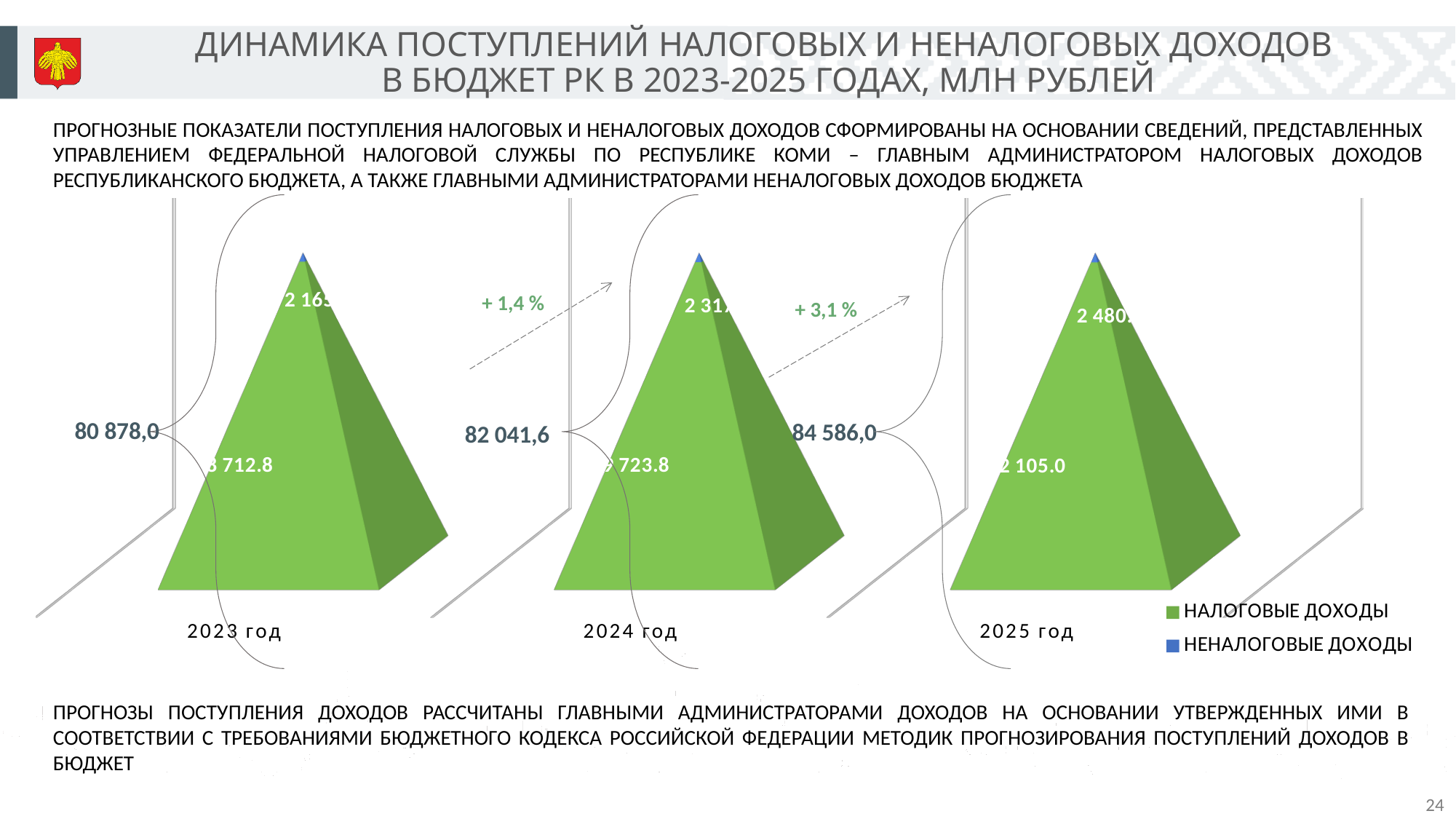
Which year has the lowest total revenue? 2023 год Which year has the highest total revenue? 2025 год What is the total revenue shown for 2025 год? 84 586,0 What is the total revenue shown for 2023 год? 80 878,0 Do the total revenues rise or fall from 2023 to 2025? rise How many years are shown on the chart? 3 What is the difference between the total for 2025 год and the total for 2023 год? 3 708,0 What is the total revenue shown for 2024 год? 82 041,6 How many series does the legend list? 2 What is the difference between the total for 2024 год and the total for 2023 год? 1 163,6 What percentage change is shown between 2023 год and 2024 год? + 1,4 % Which is larger, the total for 2024 год or the total for 2025 год? 2025 год